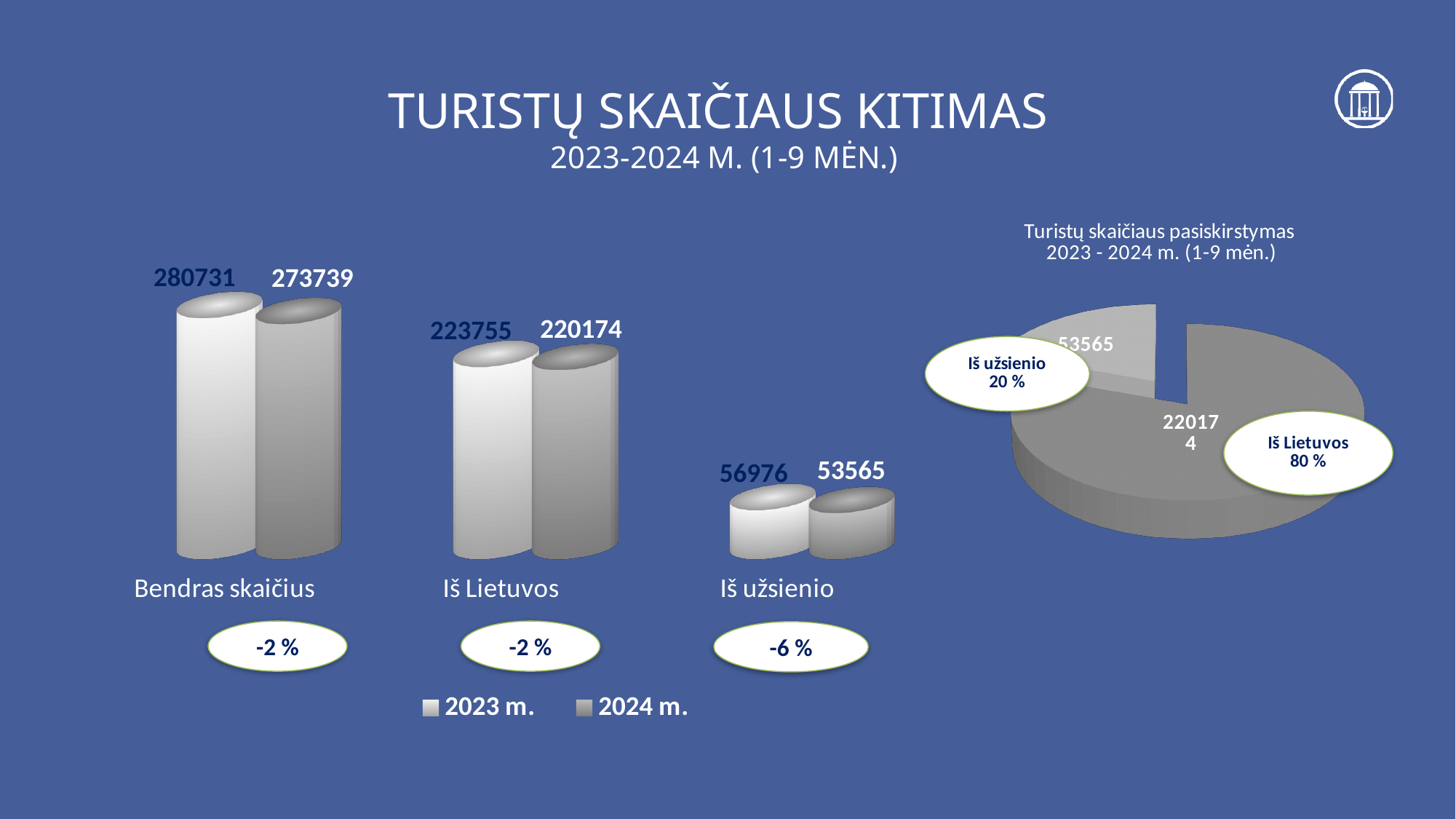
On the bar chart on the left, how many categories are shown? 3 On the bar chart on the left, what is the difference between the 2023 m. and 2024 m. values for Bendras skaičius? 6992 On the pie chart titled 'Turistų skaičiaus pasiskirstymas', what is the value of the Iš užsienio slice? 53565 What kind of chart is the chart on the left of the slide? Bar chart On the bar chart on the left, which category has the lowest value in 2023 m.? Iš užsienio On the bar chart on the left, which is larger for Iš Lietuvos: the 2023 m. value or the 2024 m. value? 2023 m. On the bar chart on the left, what is the value for Bendras skaičius in 2023 m.? 280731 On the bar chart on the left, which category has the highest value in 2024 m.? Bendras skaičius On the pie chart titled 'Turistų skaičiaus pasiskirstymas', what share does Iš Lietuvos have? 80 % On the bar chart on the left, how many series does the legend list? 2 On the bar chart on the left, what is the value for Iš užsienio in 2024 m.? 53565 On the bar chart on the left, what is the value for Iš Lietuvos in 2024 m.? 220174